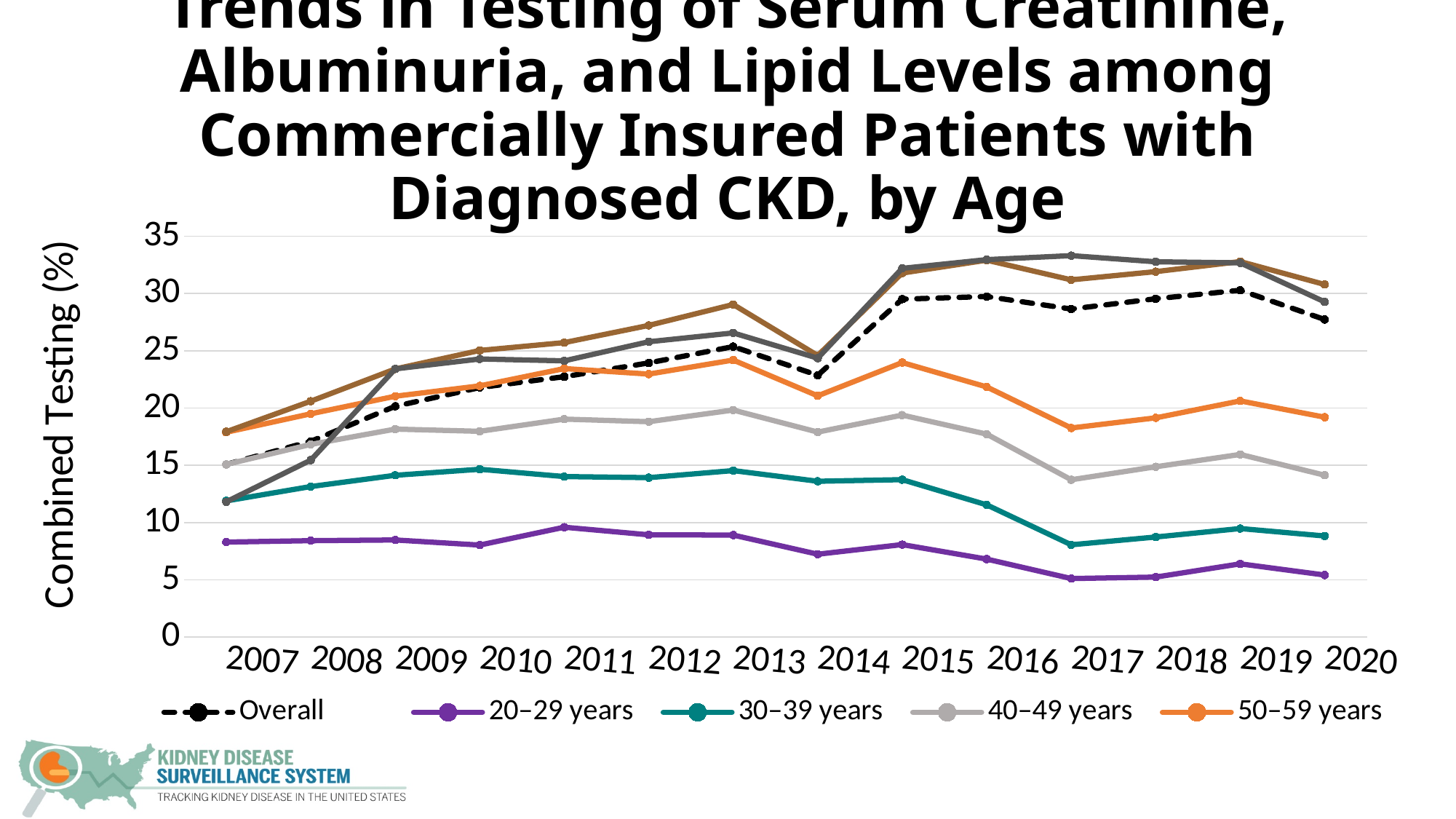
Is the value for 20–29 years in 2020 greater or less than 10? less Does the Overall line rise or fall from 2007 to 2013? rises Is the value for 50–59 years in 2015 greater or less than 20? greater Is the value for 40–49 years in 2017 greater or less than 15? less How many years are plotted along the x axis? 14 In 2012, which is larger: the value for 30–39 years or for 20–29 years? 30–39 years What is the label of the y axis? Combined Testing (%) Which of the age groups listed in the legend has the lowest value in 2020? 20–29 years In 2020, which is larger: the Overall value or the value for 50–59 years? Overall How many series does the legend list? 5 What kind of chart is shown on the slide? line chart